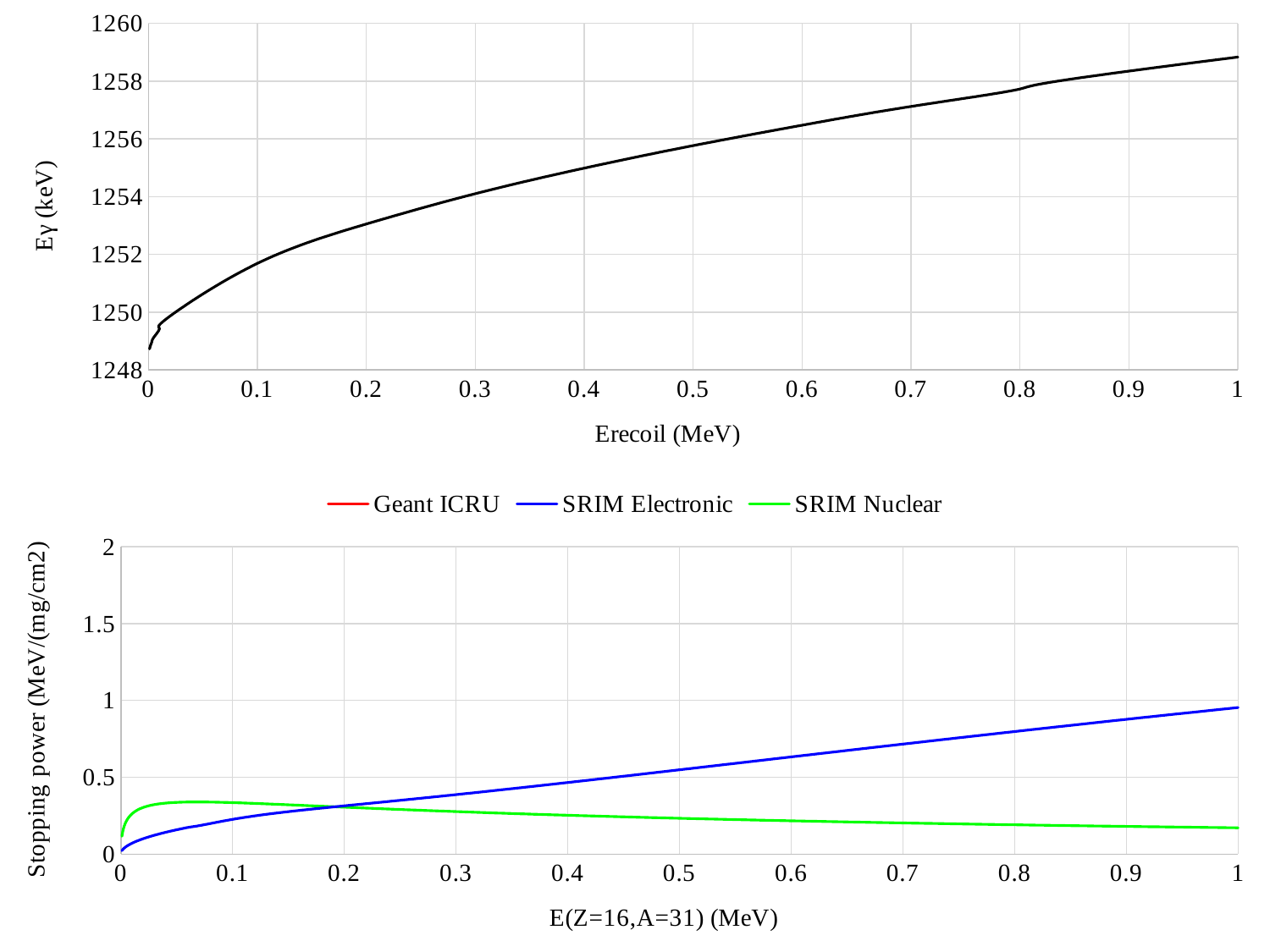
In the bottom chart (Stopping power), is the SRIM Electronic value at E = 1 MeV greater or less than 0.5? greater In the bottom chart (Stopping power), is the SRIM Nuclear value at E = 1 MeV greater or less than 0.5? less In the bottom chart (Stopping power), which series is larger at E = 1 MeV, SRIM Electronic or SRIM Nuclear? SRIM Electronic In the top chart, is the value of Eγ at Erecoil = 1 MeV greater or less than 1258 keV? greater In the top chart, does Eγ rise or fall as Erecoil increases from 0 to 1 MeV? rise In the bottom chart (Stopping power), which series is larger at E = 0.1 MeV, SRIM Electronic or SRIM Nuclear? SRIM Nuclear How many series does the legend of the bottom chart (Stopping power) list? 3 What is the x-axis label of the bottom chart (Stopping power)? E(Z=16,A=31) (MeV) In the bottom chart (Stopping power), does the SRIM Electronic series rise or fall as E increases from 0 to 1 MeV? rise What kind of chart is the top chart (Eγ vs Erecoil)? line chart